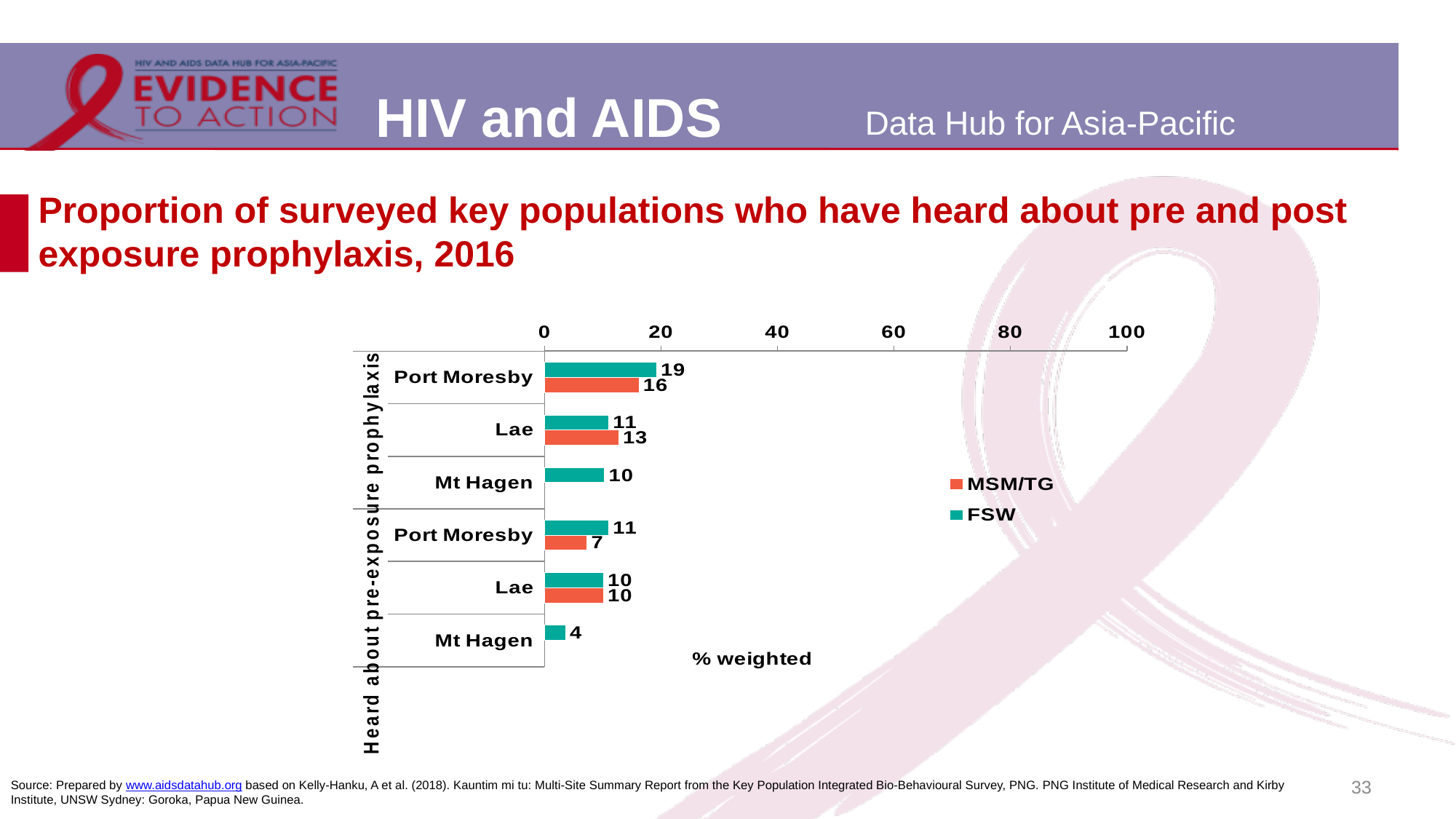
Which bar has the lowest value on the chart? FSW, Mt Hagen (bottom group), 4 Which bar has the highest value on the chart? FSW, Port Moresby (top group), 19 What is the MSM/TG value for Port Moresby in the top group of bars? 16 What is the label on the horizontal axis of the chart? % weighted What is the FSW value for Mt Hagen in the bottom group of bars? 4 What is the MSM/TG value for Lae in the top group of bars? 13 What is the MSM/TG value for Port Moresby in the bottom group of bars? 7 How many series does the legend list? 2 What is the difference between the FSW and MSM/TG values for Port Moresby in the bottom group of bars? 4 In the top group of bars, which is larger for Lae: the FSW value or the MSM/TG value? MSM/TG What is the FSW value for Port Moresby in the top group of bars? 19 What kind of chart is shown on the slide? Bar chart